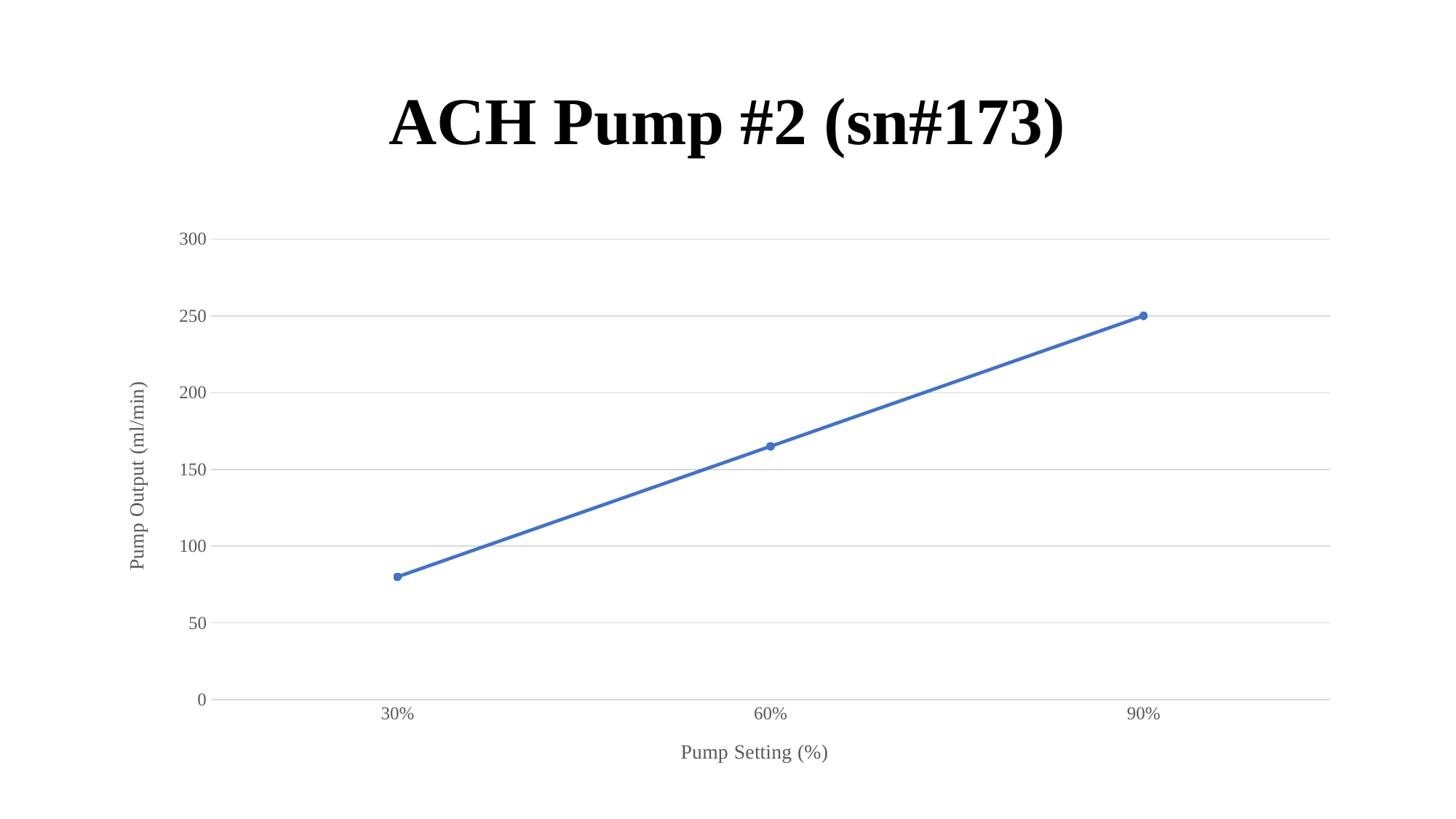
What is the pump output at the 90% pump setting? 250 What kind of chart is shown on the slide? line chart Which pump setting has the lowest pump output? 30% Does the pump output rise or fall as the pump setting increases from 30% to 90%? rise What is the label of the vertical axis? Pump Output (ml/min) What is the title of the chart? ACH Pump #2 (sn#173) Is the pump output at the 30% setting greater or less than 50? greater Is the pump output at the 30% setting greater or less than 100? less Is the pump output at the 60% setting greater or less than 150? greater How many data points are plotted on the line? 3 Which has the larger pump output, the 60% setting or the 30% setting? 60% Which pump setting has the highest pump output? 90%